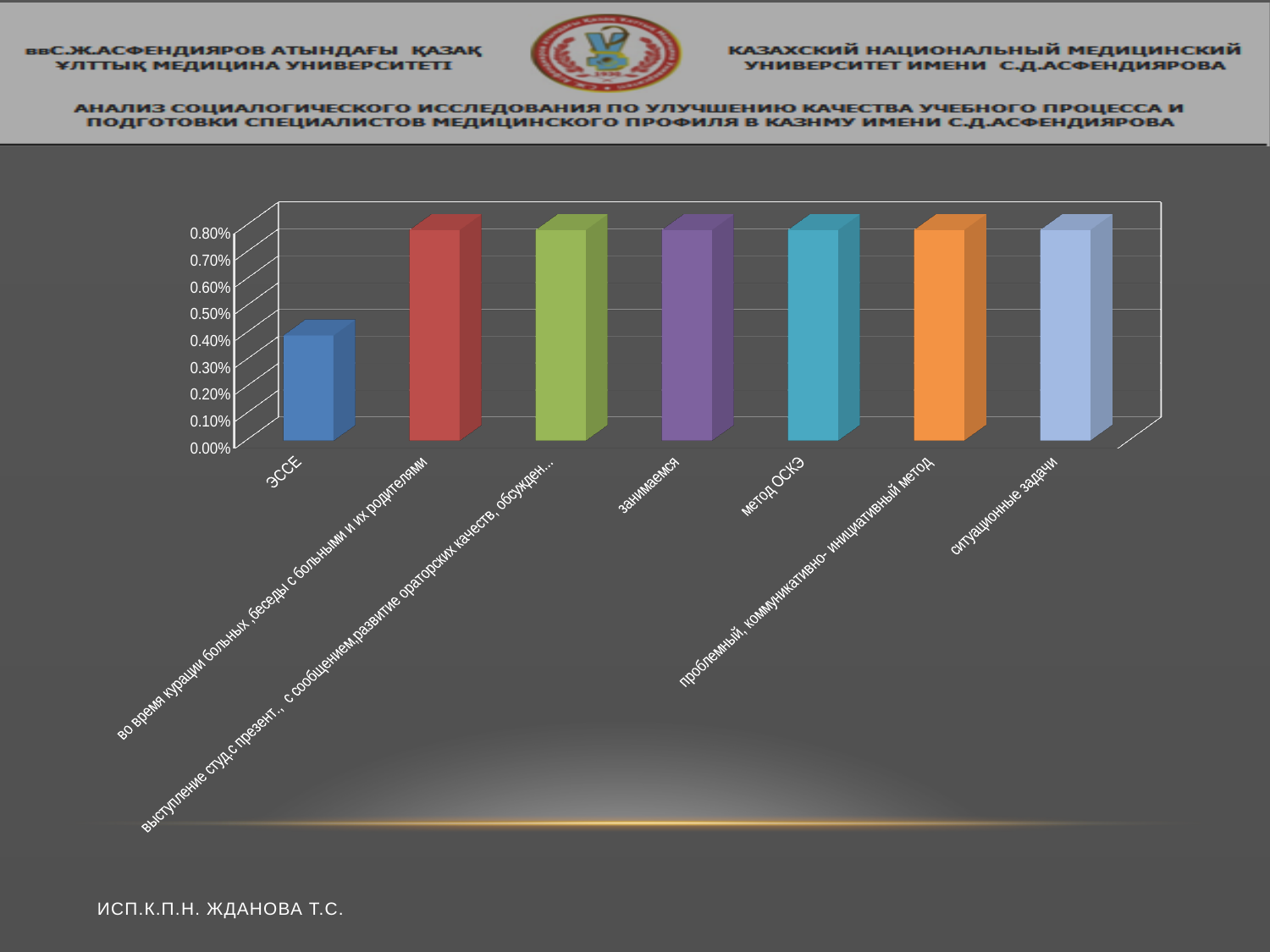
Which is larger, the value for ЭССЕ or the value for метод ОСКЭ? метод ОСКЭ Is the value for ЭССЕ greater or less than 0.50%? less Which is larger, the value for ситуационные задачи or the value for ЭССЕ? ситуационные задачи How many categories are plotted in the chart? 7 Is the value for ЭССЕ greater or less than 0.20%? greater Is the value for метод ОСКЭ greater or less than 0.70%? greater Which category has the lowest bar in the chart? ЭССЕ What colour is the bar for ЭССЕ? blue What is the highest value label shown on the vertical axis of the chart? 0.80% What kind of chart is shown on the slide? bar chart